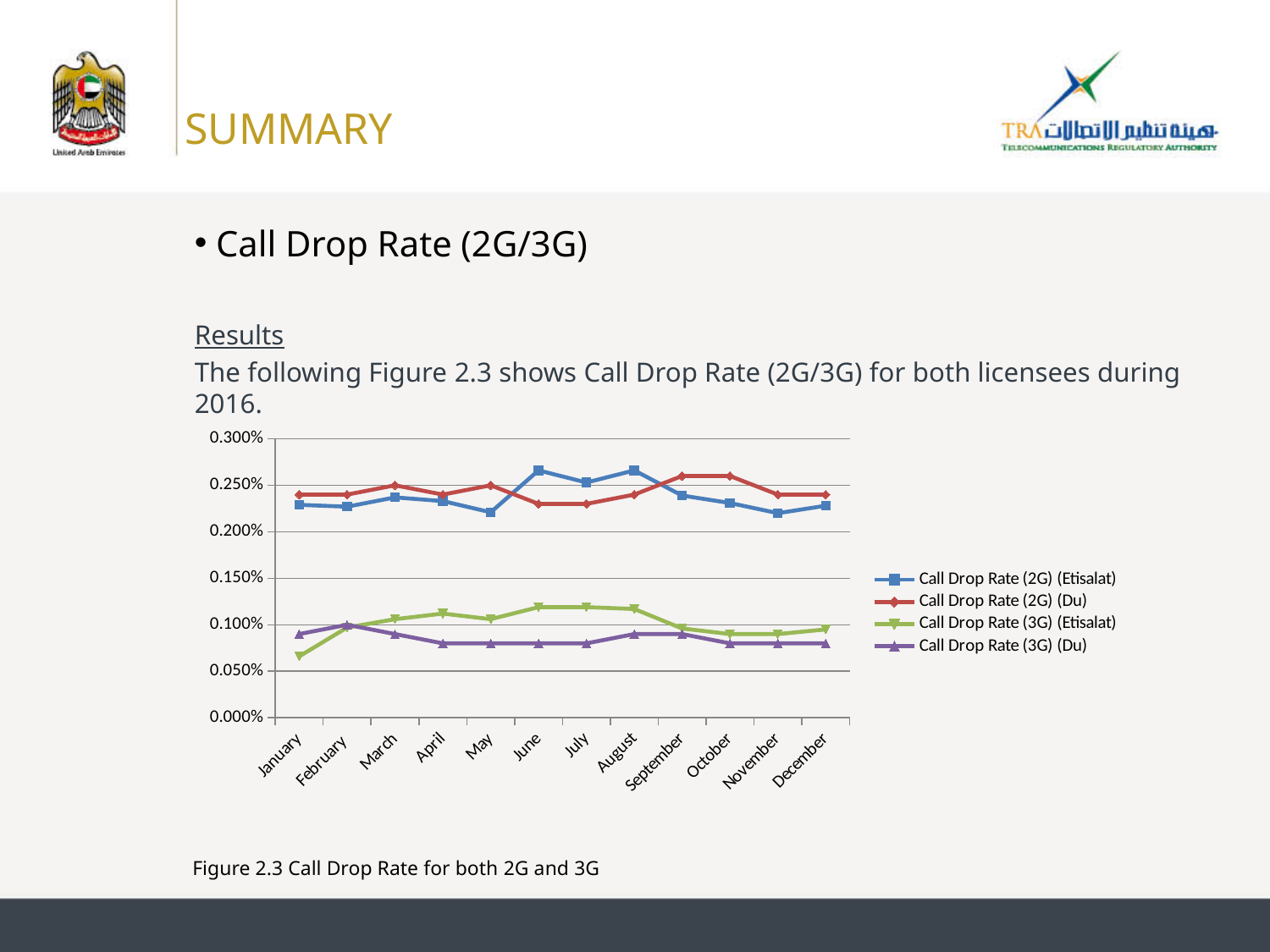
In April, which is higher: Call Drop Rate (3G) (Etisalat) or Call Drop Rate (3G) (Du)? Call Drop Rate (3G) (Etisalat) How many months are plotted along the x axis? 12 Does Call Drop Rate (2G) (Etisalat) rise or fall from August to November? fall Which month has the lowest Call Drop Rate (3G) (Etisalat)? January In October, which is higher: Call Drop Rate (2G) (Du) or Call Drop Rate (2G) (Etisalat)? Call Drop Rate (2G) (Du) Is the value for Call Drop Rate (2G) (Du) in September greater or less than 0.250%? greater Is the value for Call Drop Rate (2G) (Etisalat) in June greater or less than 0.250%? greater What kind of chart is shown on the slide? line chart How many series does the legend list? 4 In June, which is higher: Call Drop Rate (2G) (Etisalat) or Call Drop Rate (2G) (Du)? Call Drop Rate (2G) (Etisalat) Is the value for Call Drop Rate (3G) (Du) in May greater or less than 0.100%? less